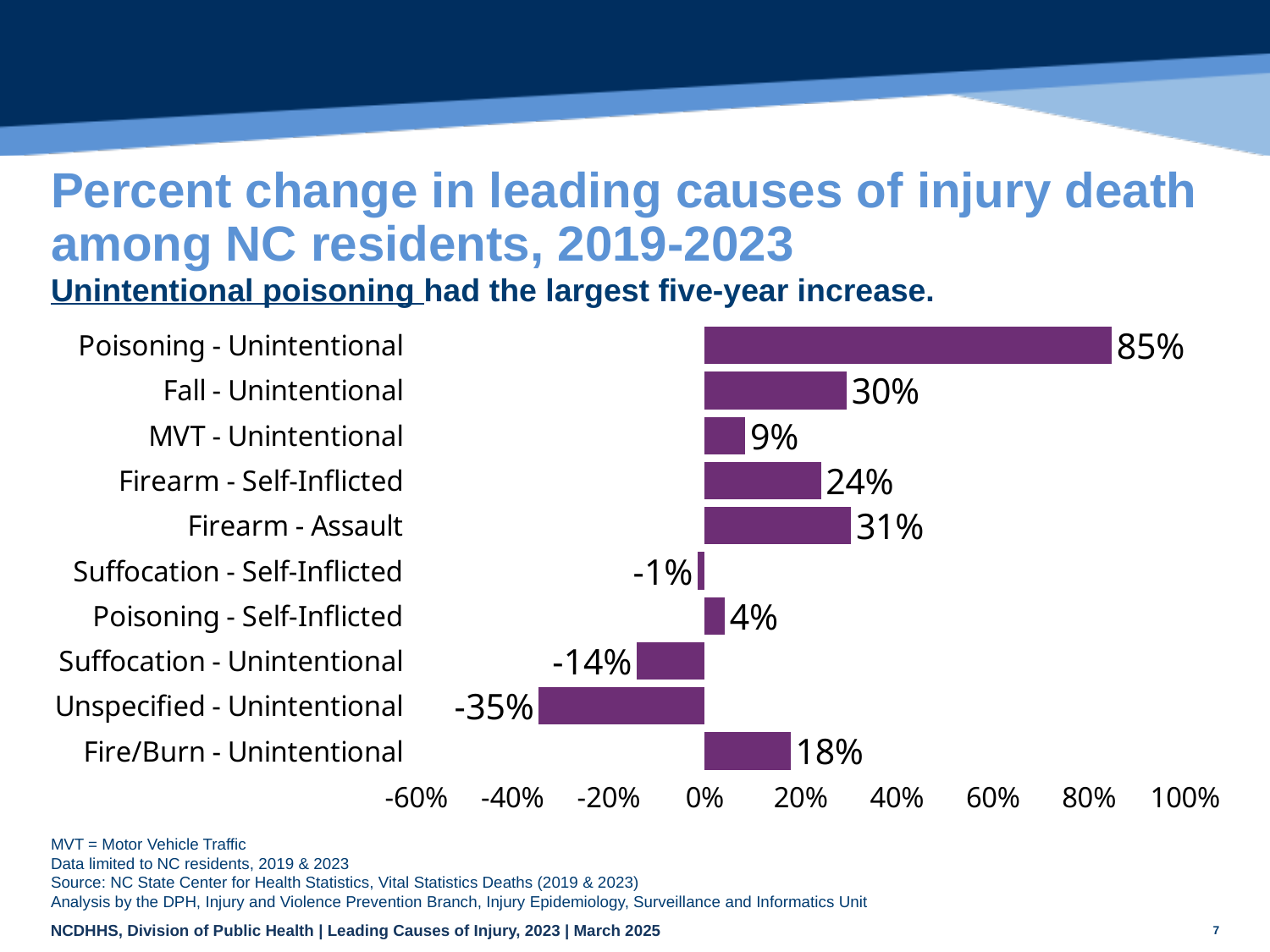
What kind of chart is shown on the slide? Bar chart How many causes of injury death are shown in the chart? 10 What is the percent change for Unspecified - Unintentional? -35% What is the title of the chart on the slide? Percent change in leading causes of injury death among NC residents, 2019-2023 What is the percent change for Fire/Burn - Unintentional? 18% What is the percent change for Suffocation - Self-Inflicted? -1% What is the percent change for Poisoning - Unintentional? 85% Which cause of injury death has the highest percent change? Poisoning - Unintentional What is the difference between the percent change for Firearm - Assault and Firearm - Self-Inflicted? 7% Which has a larger percent change, Fall - Unintentional or MVT - Unintentional? Fall - Unintentional Which cause of injury death has the lowest percent change? Unspecified - Unintentional How many causes of injury death show a negative percent change? 3